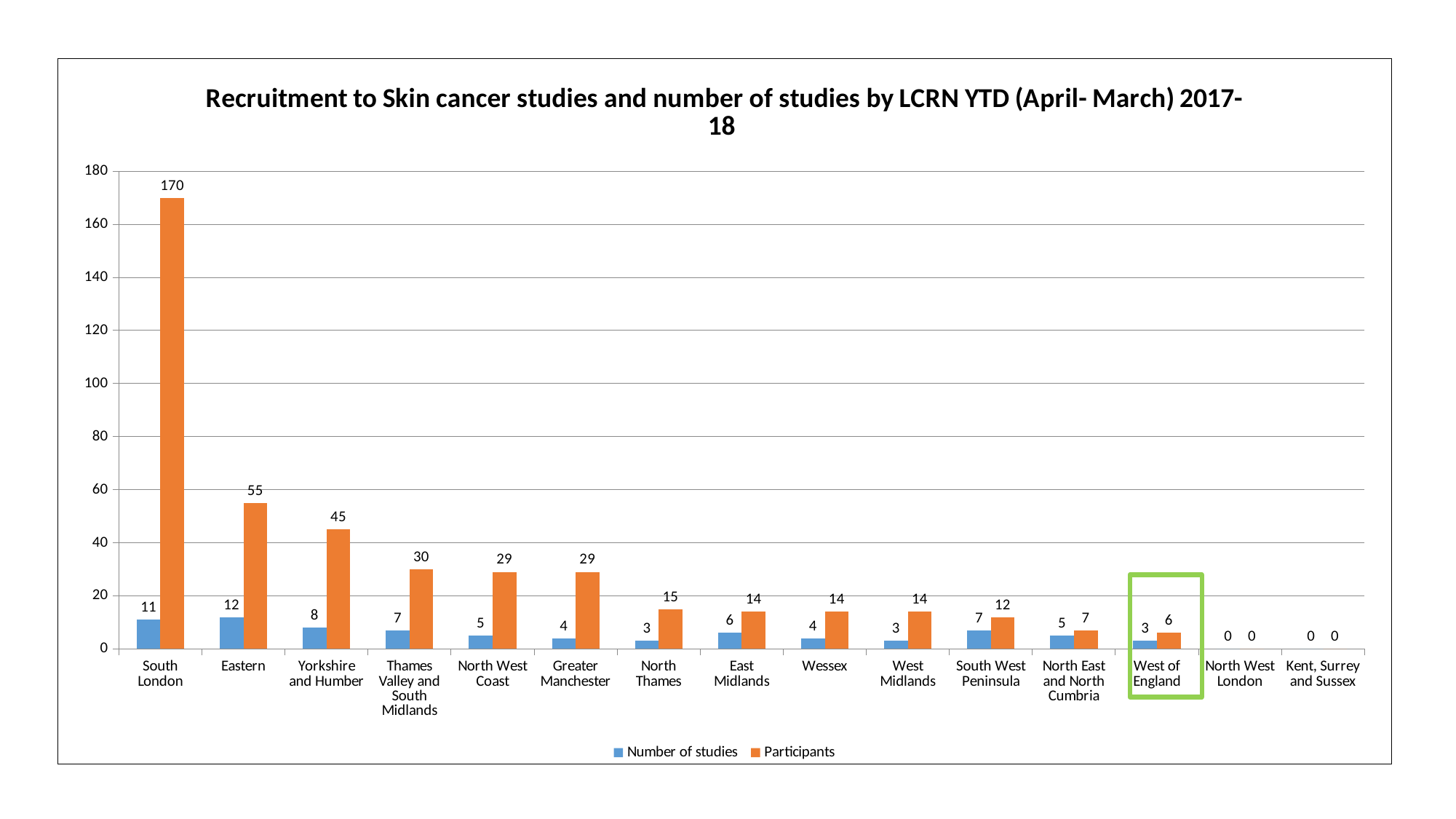
How many LCRN categories are shown on the x axis? 15 Which LCRN has the highest number of Participants? South London How many series does the legend list? 2 What is the difference in Participants between South London and Eastern? 115 Which LCRN has the highest Number of studies? Eastern What is the Number of studies for Eastern? 12 Which has more Participants, Yorkshire and Humber or North West Coast? Yorkshire and Humber Which LCRN is highlighted with a green box? West of England What kind of chart is shown on the slide? Bar chart How many Participants does Thames Valley and South Midlands have? 30 What is the Number of studies for West of England? 3 How many Participants does South London have? 170